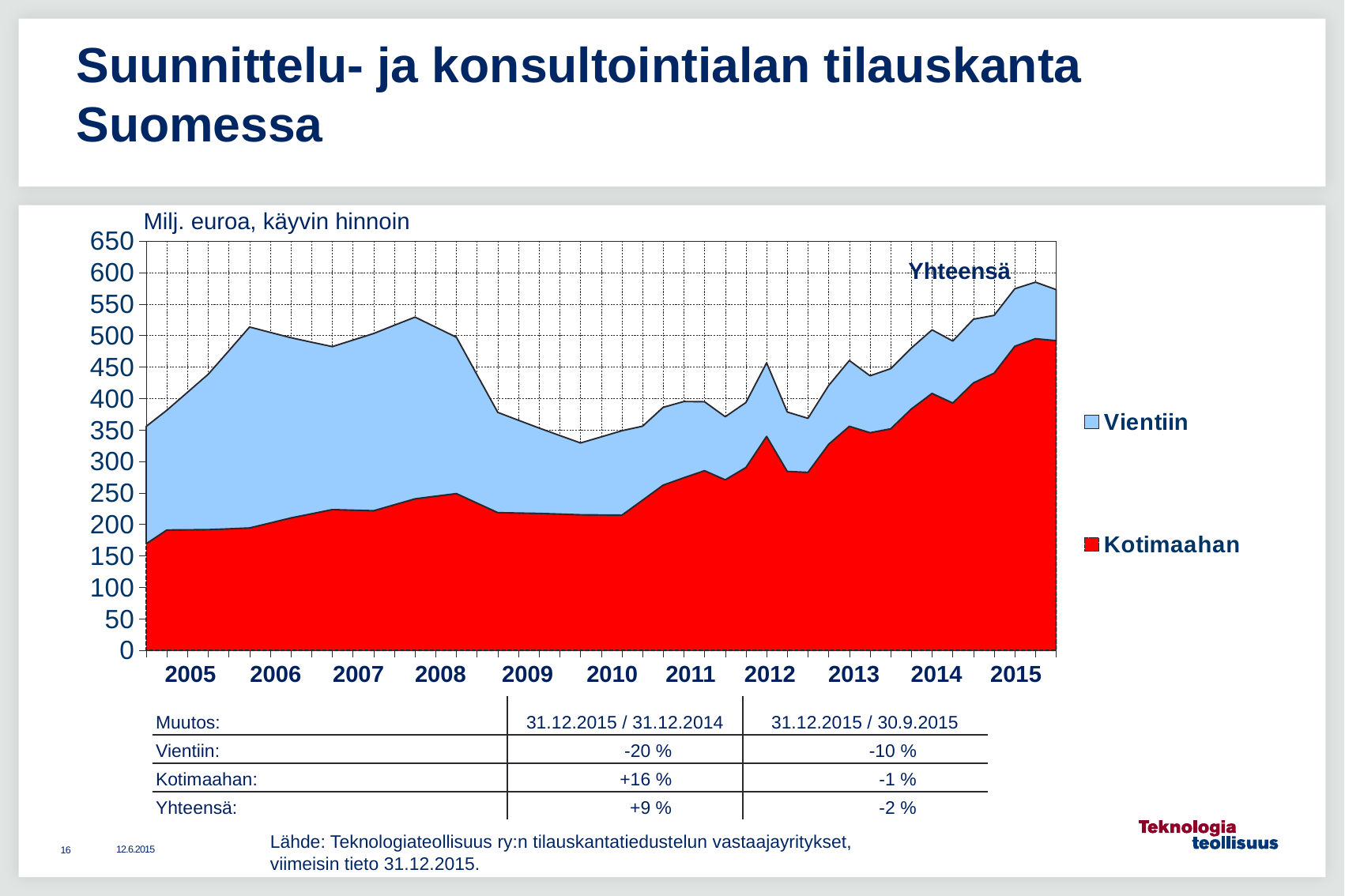
At the end of 2015, which series is larger, Vientiin or Kotimaahan? Kotimaahan Is the total (Yhteensä) value at the end of 2015 greater or less than 550? greater Does the total (Yhteensä) rise or fall from 2008 to 2010? fall What are the two series named in the chart legend? Vientiin and Kotimaahan Is the Kotimaahan value at the end of 2015 greater or less than 450? greater How many series does the chart legend list? 2 Does the Kotimaahan series rise or fall from 2012 to 2015? rise Is the Kotimaahan value at the start of 2005 greater or less than 200? less What kind of chart is shown on the slide? Stacked area chart How many years are labelled on the x axis of the chart? 11 What unit is stated above the chart's y axis? Milj. euroa, käyvin hinnoin